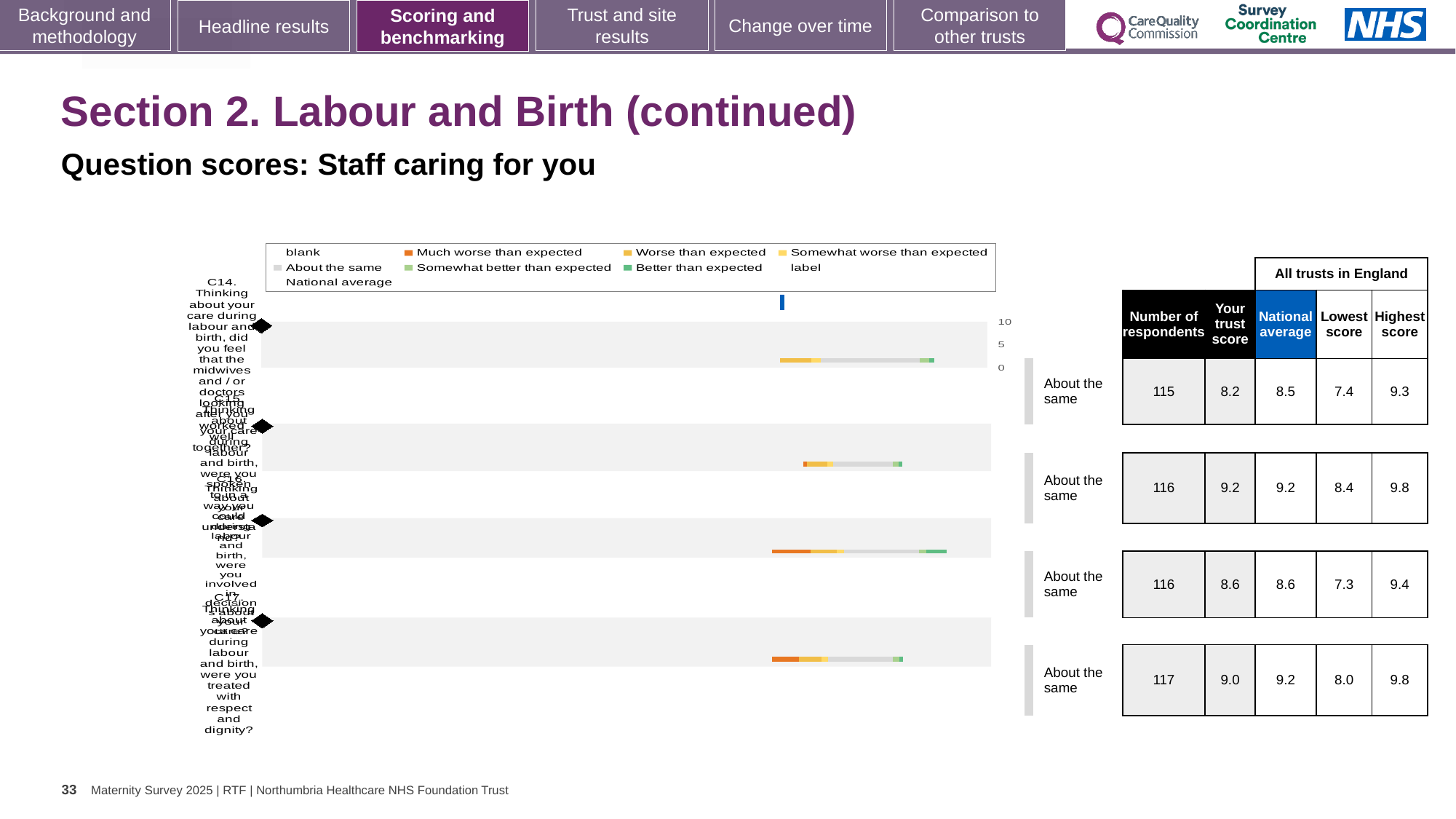
What colour does the legend use for 'Much worse than expected'? orange How many entries does the chart legend list? 9 How many question bars are plotted in the chart? 4 In the table beside the chart, what is 'Your trust score' for the first row (C14)? 8.2 In the table beside the chart, what is the national average for the last row (C17)? 9.2 What kind of chart is shown on the slide? bar chart Which row in the table has the highest number of respondents? the last row (C17), 117 For the first row (C14), which is larger: the trust score or the national average? national average For the first row (C14), what is the difference between the highest score and the lowest score in the table? 1.9 In the table beside the chart, what is the number of respondents for the first row (C14)? 115 What is the subtitle describing the question scores shown in the chart? Question scores: Staff caring for you